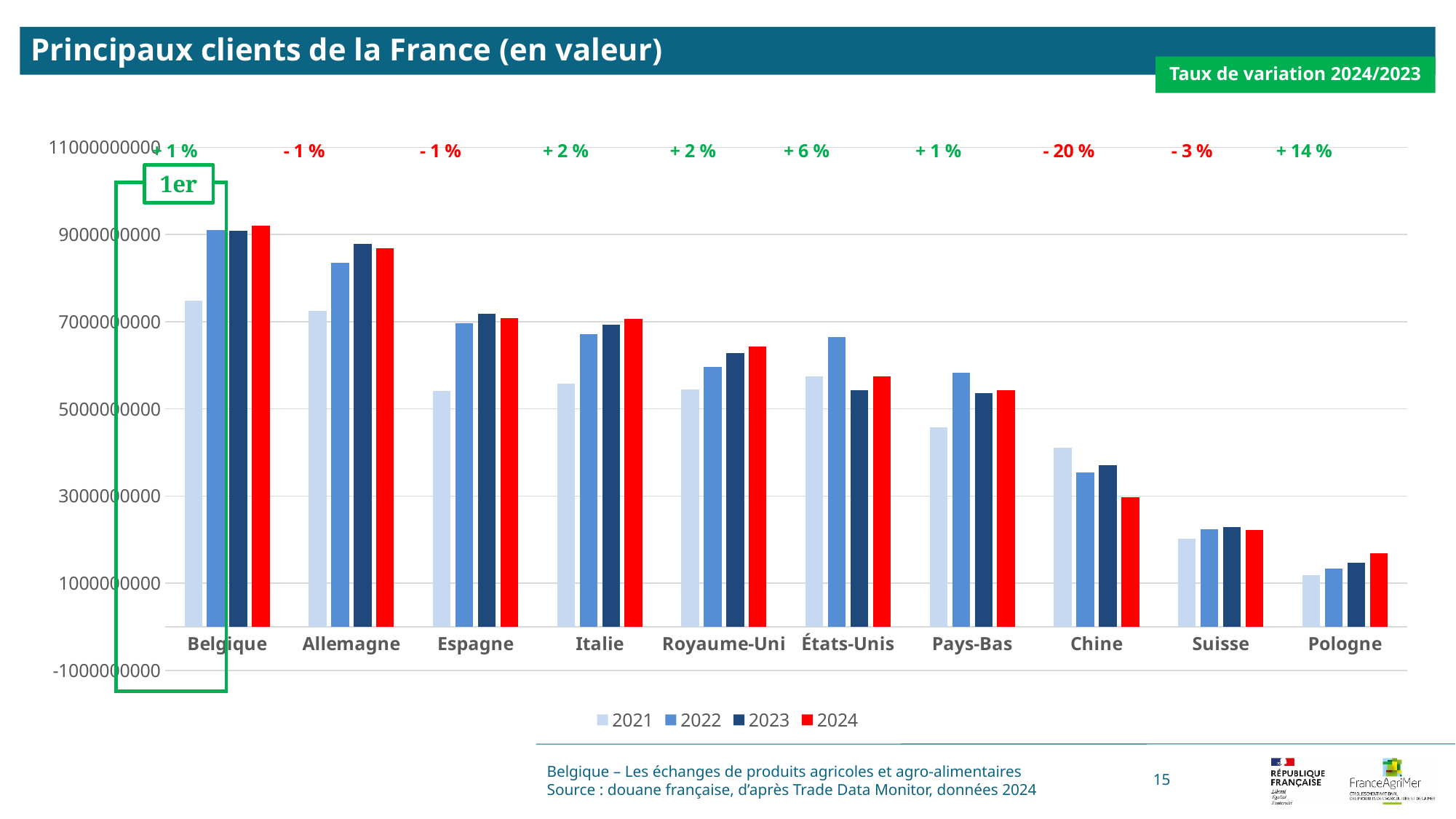
Which country has the lowest 2024 value in the chart? Pologne What is the 2024/2023 variation rate shown above Chine? - 20 % What is the 2024/2023 variation rate shown above Pologne? + 14 % Is the 2024 value for Suisse greater or less than 3000000000? less Is the 2024 value for Belgique greater or less than 9000000000? greater Which country has the highest 2024 value in the chart? Belgique Which is larger for Chine: the 2021 value or the 2024 value? 2021 How many series does the legend list? 4 What kind of chart is shown on the slide? bar chart What is the 2024/2023 variation rate shown above États-Unis? + 6 % What is the title of the chart? Principaux clients de la France (en valeur) How many countries are shown on the x axis of the chart? 10